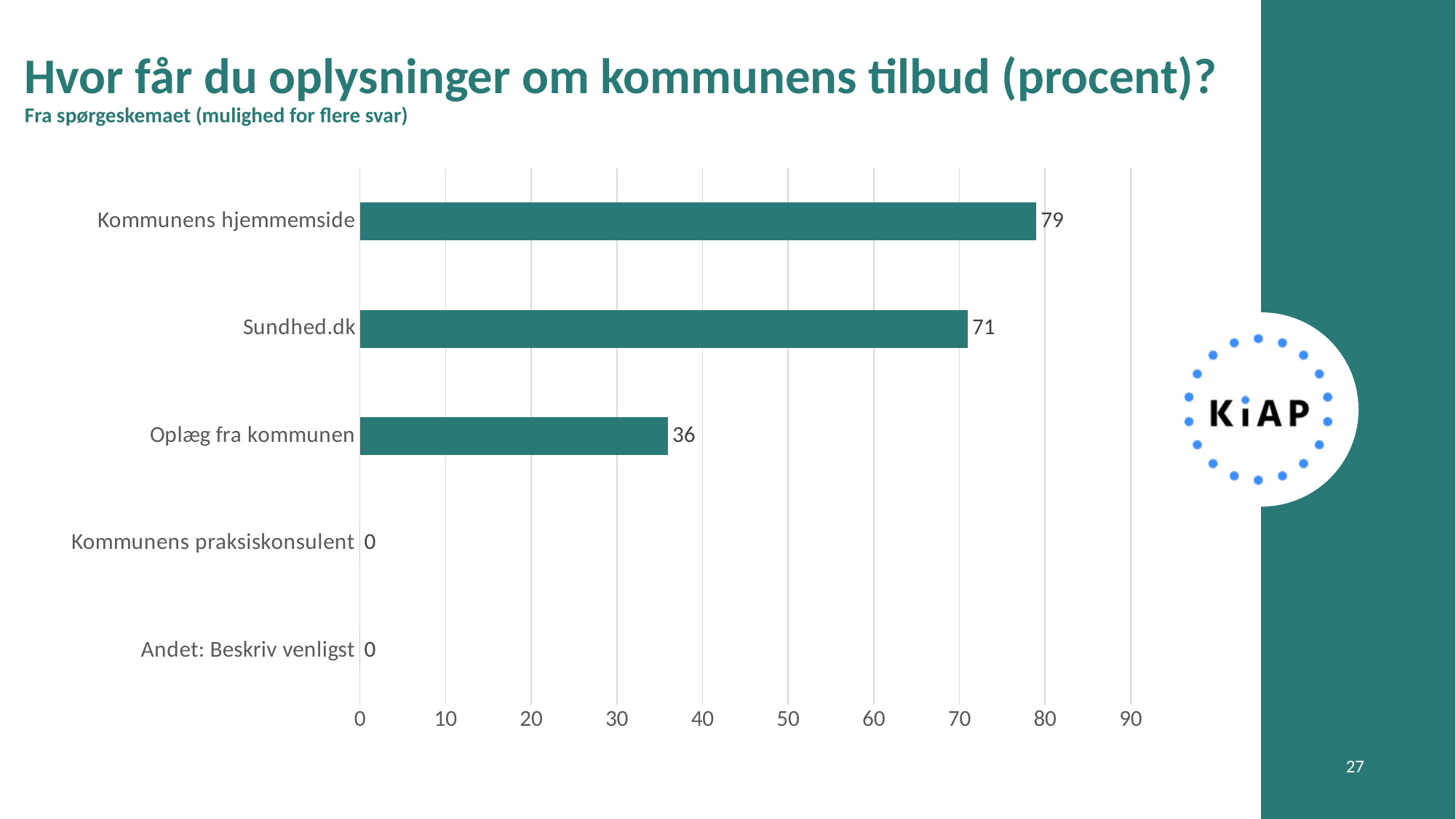
What kind of chart is shown on the slide? bar chart What is the difference between the values for Sundhed.dk and Oplæg fra kommunen? 35 What is the difference between the values for Kommunens hjemmemside and Sundhed.dk? 8 Which category has the highest value? Kommunens hjemmemside What is the value for Kommunens hjemmemside? 79 What is the value for Kommunens praksiskonsulent? 0 What is the value for Oplæg fra kommunen? 36 What is the value for Sundhed.dk? 71 Is the value for Oplæg fra kommunen greater or less than 40? less How many categories are shown on the chart? 5 What is the title of the chart on the slide? Hvor får du oplysninger om kommunens tilbud (procent)? Which is larger, the value for Sundhed.dk or the value for Oplæg fra kommunen? Sundhed.dk